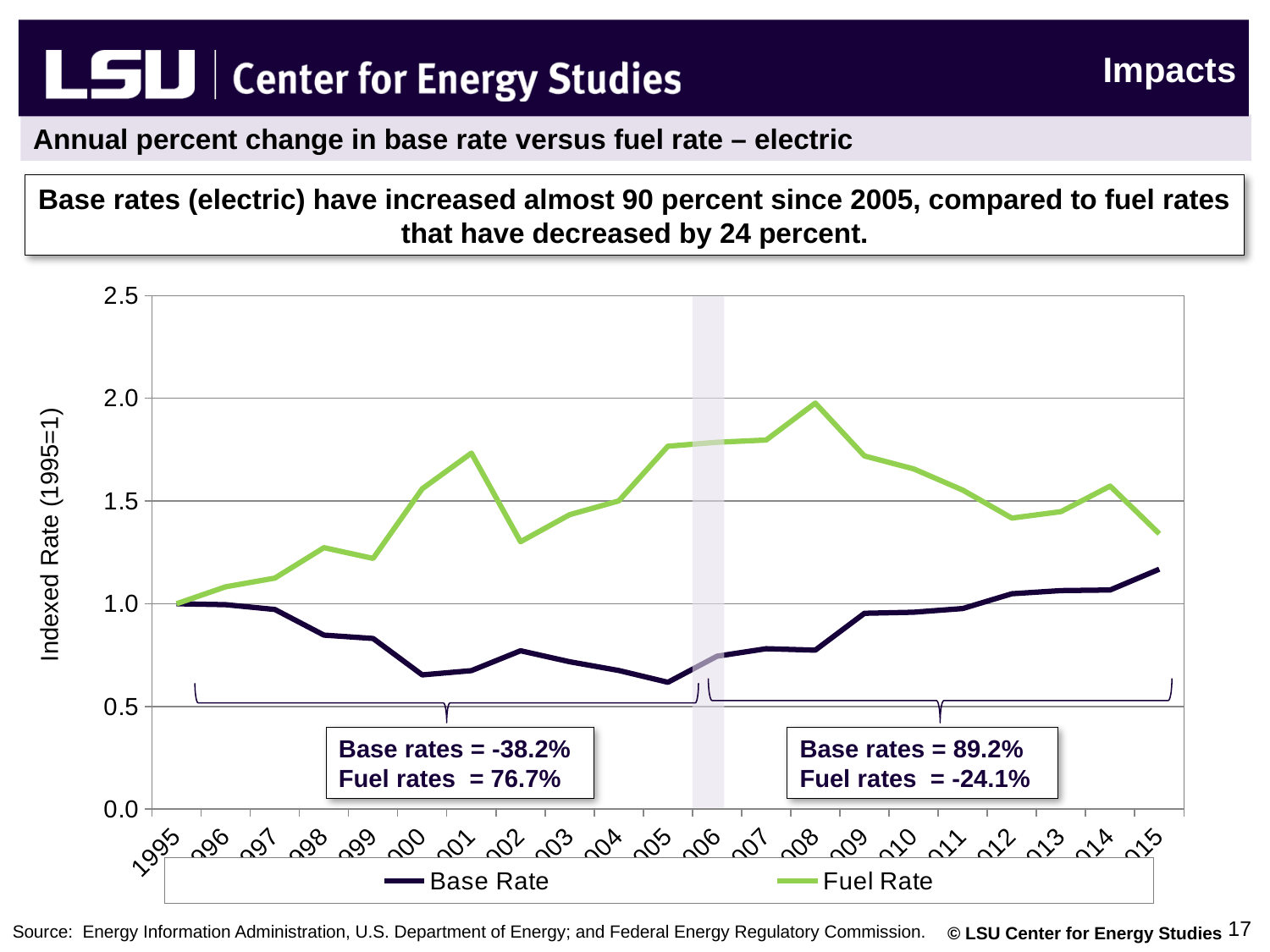
What is the Base Rate value in 1995? 1.0 What is the label on the y axis? Indexed Rate (1995=1) What kind of chart is shown on the slide? line chart How many series does the legend list? 2 How many years are plotted along the x axis? 21 In which year does the Base Rate reach its highest value? 2015 In 2008, which is larger, the Base Rate or the Fuel Rate? Fuel Rate Is the Base Rate value for 2005 greater or less than 1.0? less According to the annotation, what was the percent change in base rates between 2005 and 2015? 89.2% Is the Fuel Rate value for 2008 greater or less than 1.5? greater In which year does the Fuel Rate reach its highest value? 2008 According to the annotation, what was the percent change in fuel rates between 1995 and 2005? 76.7%